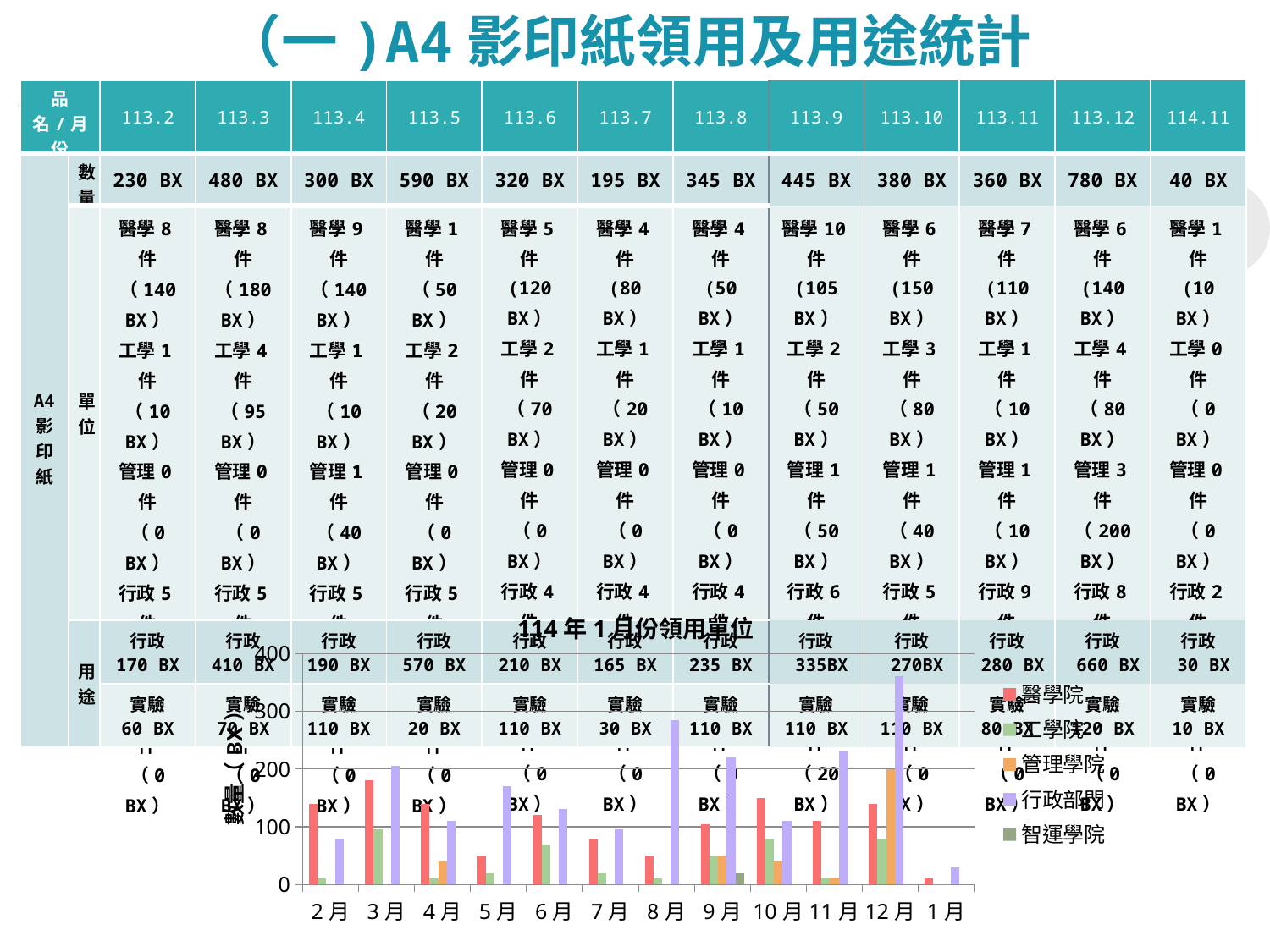
Is the value for 醫學院 in 3月 greater or less than 100? greater Is the value for 醫學院 in 5月 greater or less than 100? less In which month is the 醫學院 bar the highest? 3月 What is the label of the chart's y axis? 數量（BX） How many months are shown on the x axis of the chart? 12 In 8月, which is larger: the 醫學院 bar or the 行政部門 bar? 行政部門 What kind of chart is shown on the slide? bar chart How many series does the chart legend list? 5 In which month is the 行政部門 bar the highest? 12月 What is the title of the chart? 114年1月份領用單位 In which month is the 行政部門 bar the lowest? 1月 Is the value for 行政部門 in 9月 greater or less than 200? greater